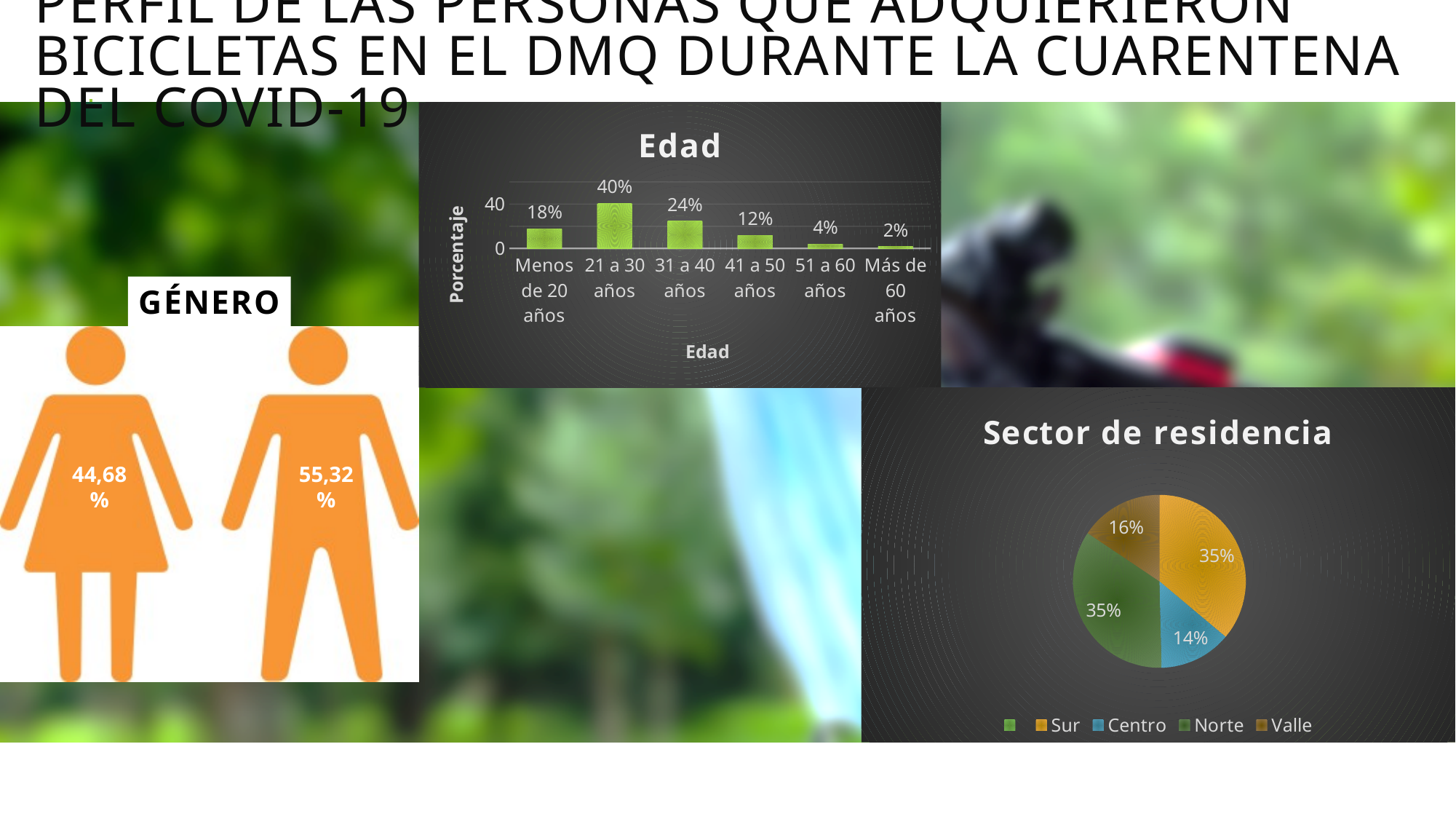
In the 'Edad' chart, what is the value for '21 a 30 años'? 40% What kind of chart is the 'Sector de residencia' chart? Pie chart In the 'Sector de residencia' chart, what share does 'Centro' have? 14% In the 'Sector de residencia' chart, which sector has the smallest share? Centro How many age categories are shown in the 'Edad' chart? 6 What kind of chart is the 'Edad' chart? Bar chart In the 'Edad' chart, what is the value for 'Menos de 20 años'? 18% In the 'Edad' chart, what is the difference between the values for '21 a 30 años' and '31 a 40 años'? 16% In the 'Edad' chart, which age group has the highest percentage? 21 a 30 años In the 'Edad' chart, do the values rise or fall from '21 a 30 años' to 'Más de 60 años'? Fall In the 'Edad' chart, which is larger: the value for '41 a 50 años' or '51 a 60 años'? 41 a 50 años In the 'Edad' chart, which age group has the lowest percentage? Más de 60 años